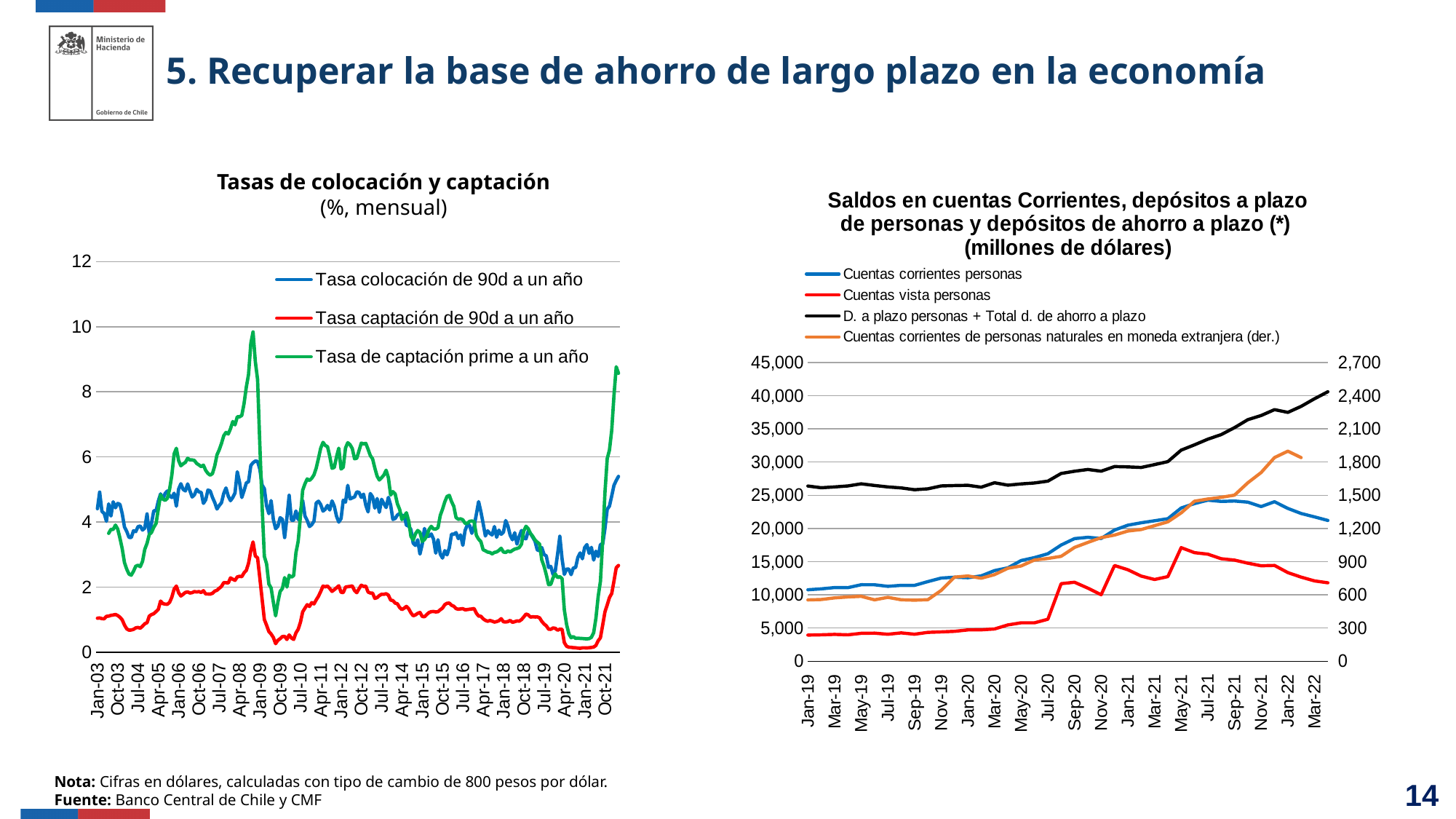
How many series does the legend of the right chart 'Saldos en cuentas Corrientes, depósitos a plazo de personas y depósitos de ahorro a plazo (*)' list? 4 In the right chart 'Saldos en cuentas Corrientes...', does the series 'D. a plazo personas + Total d. de ahorro a plazo' rise or fall from Jan-19 to Mar-22? rise What kind of chart is the left chart titled 'Tasas de colocación y captación'? line chart In the left chart 'Tasas de colocación y captación', at the end of the series (Oct-21), which is higher: 'Tasa de captación prime a un año' or 'Tasa captación de 90d a un año'? Tasa de captación prime a un año In the right chart 'Saldos en cuentas Corrientes...', is the value of 'D. a plazo personas + Total d. de ahorro a plazo' at Mar-22 greater or less than 35,000? greater How many series does the legend of the left chart 'Tasas de colocación y captación' list? 3 In the left chart 'Tasas de colocación y captación', is the value of 'Tasa captación de 90d a un año' at Oct-09 greater or less than 2? less In the left chart 'Tasas de colocación y captación', is the peak value of 'Tasa de captación prime a un año' around Apr-08 greater or less than 8? greater In the right chart 'Saldos en cuentas Corrientes...', which series is plotted against the right-hand axis according to the legend? Cuentas corrientes de personas naturales en moneda extranjera (der.) What unit is given in the subtitle of the left chart 'Tasas de colocación y captación'? %, mensual In the right chart 'Saldos en cuentas Corrientes...', at Mar-22, which is higher: 'D. a plazo personas + Total d. de ahorro a plazo' or 'Cuentas corrientes personas'? D. a plazo personas + Total d. de ahorro a plazo